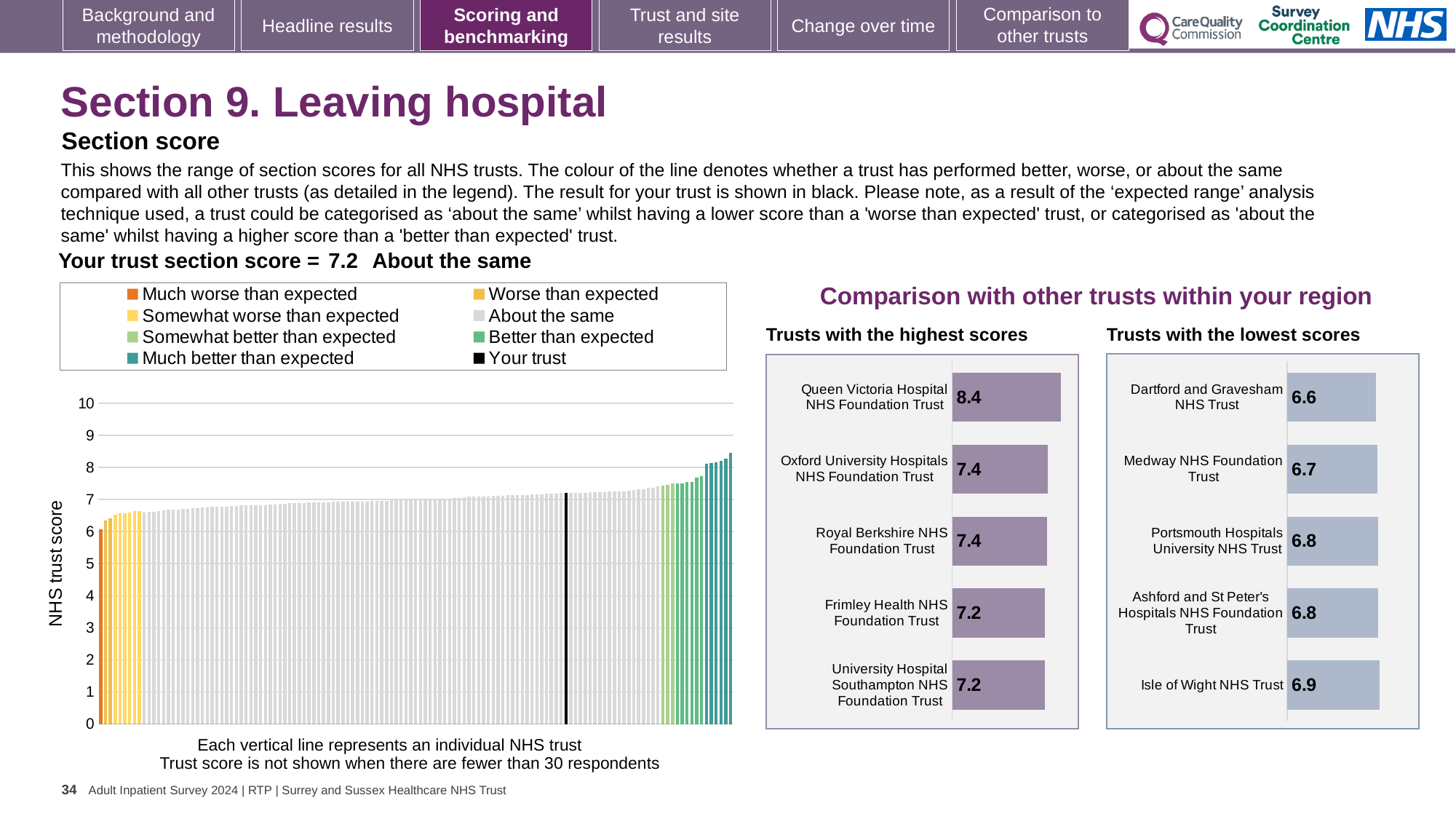
In the 'Trusts with the lowest scores' chart, which has the larger score: Isle of Wight NHS Trust or Dartford and Gravesham NHS Trust? Isle of Wight NHS Trust In the 'Trusts with the highest scores' chart, what is the difference between the scores of Queen Victoria Hospital NHS Foundation Trust and Oxford University Hospitals NHS Foundation Trust? 1.0 In the 'Trusts with the highest scores' chart, what is the score for Queen Victoria Hospital NHS Foundation Trust? 8.4 In the main chart on the left showing all NHS trusts, do the scores rise or fall from left to right along the x axis? rise In the 'Trusts with the lowest scores' chart, which trust has the lowest score? Dartford and Gravesham NHS Trust In the 'Trusts with the highest scores' chart, which trust has the highest score? Queen Victoria Hospital NHS Foundation Trust In the 'Trusts with the highest scores' chart, what is the score for Frimley Health NHS Foundation Trust? 7.2 How many trusts are shown in the 'Trusts with the lowest scores' chart? 5 What is the section score for your trust shown on the slide? 7.2 How many entries does the legend of the main chart on the left list? 8 In the 'Trusts with the lowest scores' chart, what is the score for Medway NHS Foundation Trust? 6.7 In the main chart on the left showing all NHS trusts, is the value of the highest bar greater or less than 9? less